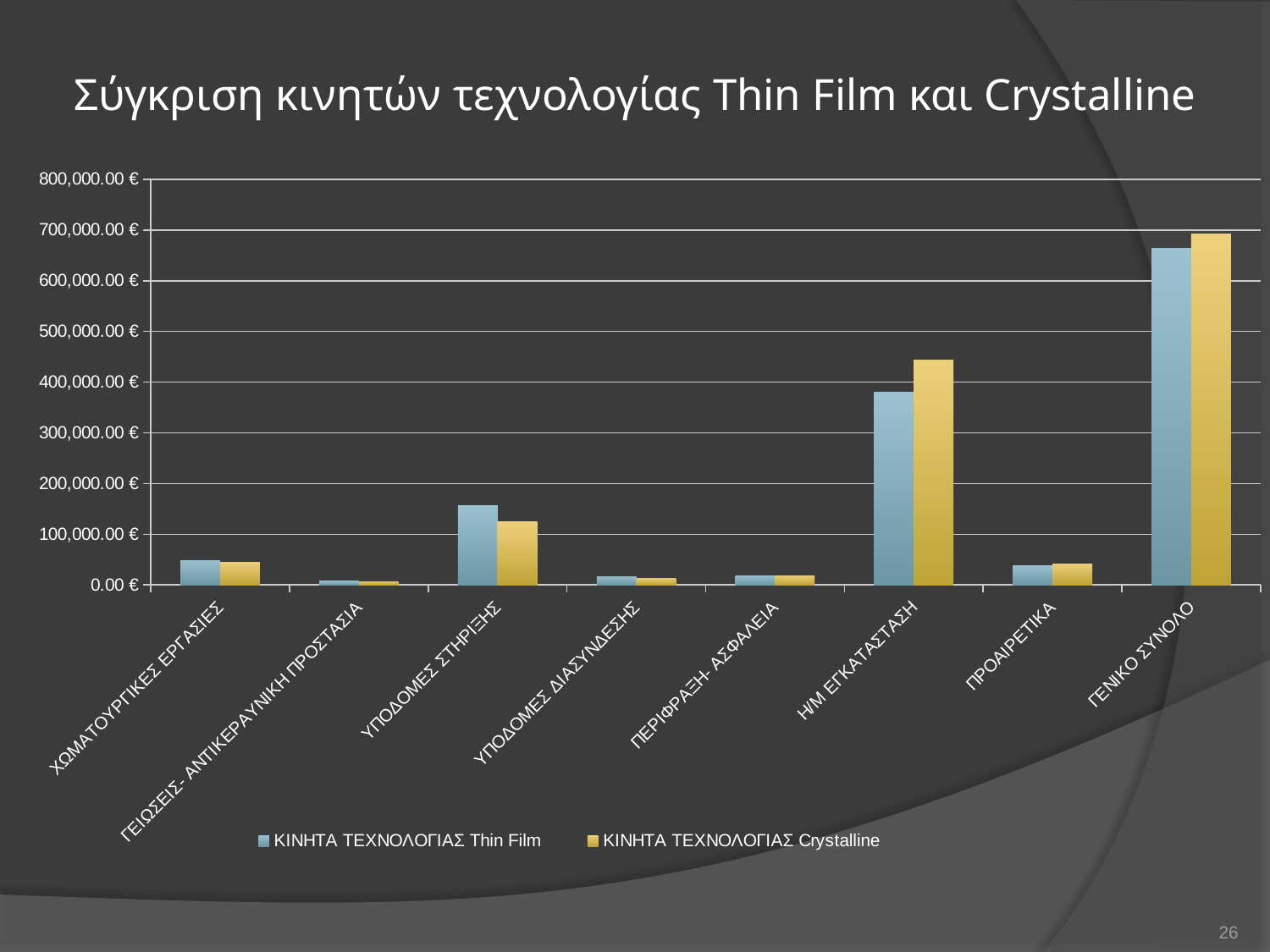
Which category has the lowest value for ΚΙΝΗΤΑ ΤΕΧΝΟΛΟΓΙΑΣ Thin Film? ΓΕΙΩΣΕΙΣ- ΑΝΤΙΚΕΡΑΥΝΙΚΗ ΠΡΟΣΤΑΣΙΑ What kind of chart is shown on the slide? Bar chart Is the value for ΚΙΝΗΤΑ ΤΕΧΝΟΛΟΓΙΑΣ Crystalline in Η/Μ ΕΓΚΑΤΑΣΤΑΣΗ greater or less than 400,000.00 €? greater How many categories are shown along the x axis of the chart? 8 What is the title of the chart on the slide? Σύγκριση κινητών τεχνολογίας Thin Film και Crystalline Is the value for ΚΙΝΗΤΑ ΤΕΧΝΟΛΟΓΙΑΣ Thin Film in ΥΠΟΔΟΜΕΣ ΣΤΗΡΙΞΗΣ greater or less than 100,000.00 €? greater In Η/Μ ΕΓΚΑΤΑΣΤΑΣΗ, which series has the larger value, ΚΙΝΗΤΑ ΤΕΧΝΟΛΟΓΙΑΣ Thin Film or ΚΙΝΗΤΑ ΤΕΧΝΟΛΟΓΙΑΣ Crystalline? ΚΙΝΗΤΑ ΤΕΧΝΟΛΟΓΙΑΣ Crystalline Is the value for ΚΙΝΗΤΑ ΤΕΧΝΟΛΟΓΙΑΣ Thin Film in Η/Μ ΕΓΚΑΤΑΣΤΑΣΗ greater or less than 400,000.00 €? less Which category has the highest value for ΚΙΝΗΤΑ ΤΕΧΝΟΛΟΓΙΑΣ Crystalline? ΓΕΝΙΚΟ ΣΥΝΟΛΟ How many series does the chart's legend list? 2 In ΥΠΟΔΟΜΕΣ ΣΤΗΡΙΞΗΣ, which series has the larger value, ΚΙΝΗΤΑ ΤΕΧΝΟΛΟΓΙΑΣ Thin Film or ΚΙΝΗΤΑ ΤΕΧΝΟΛΟΓΙΑΣ Crystalline? ΚΙΝΗΤΑ ΤΕΧΝΟΛΟΓΙΑΣ Thin Film